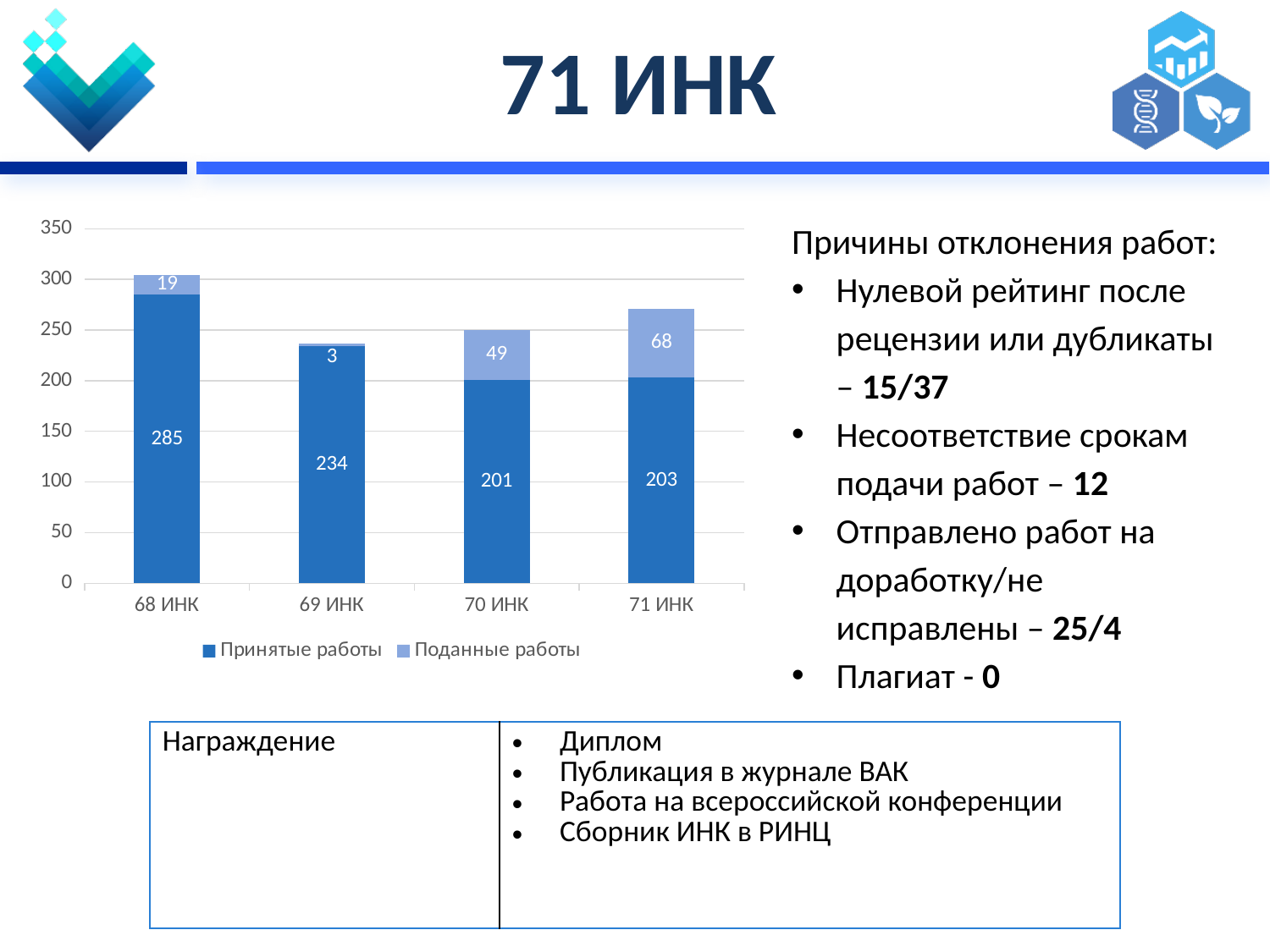
How many categories are shown on the x axis of the chart? 4 What is the value of Принятые работы for 70 ИНК? 201 Which series is shown in dark blue in the chart legend? Принятые работы What is the value of Принятые работы for 68 ИНК? 285 What type of chart is shown on the slide? Stacked bar chart What is the difference between Принятые работы for 68 ИНК and 69 ИНК? 51 Which category has the lowest value for Поданные работы? 69 ИНК How many series does the chart legend list? 2 Which is larger: Поданные работы for 70 ИНК or for 71 ИНК? 71 ИНК Which category has the highest value for Принятые работы? 68 ИНК What is the value of Поданные работы for 71 ИНК? 68 What is the total of the stacked bar for 71 ИНК? 271